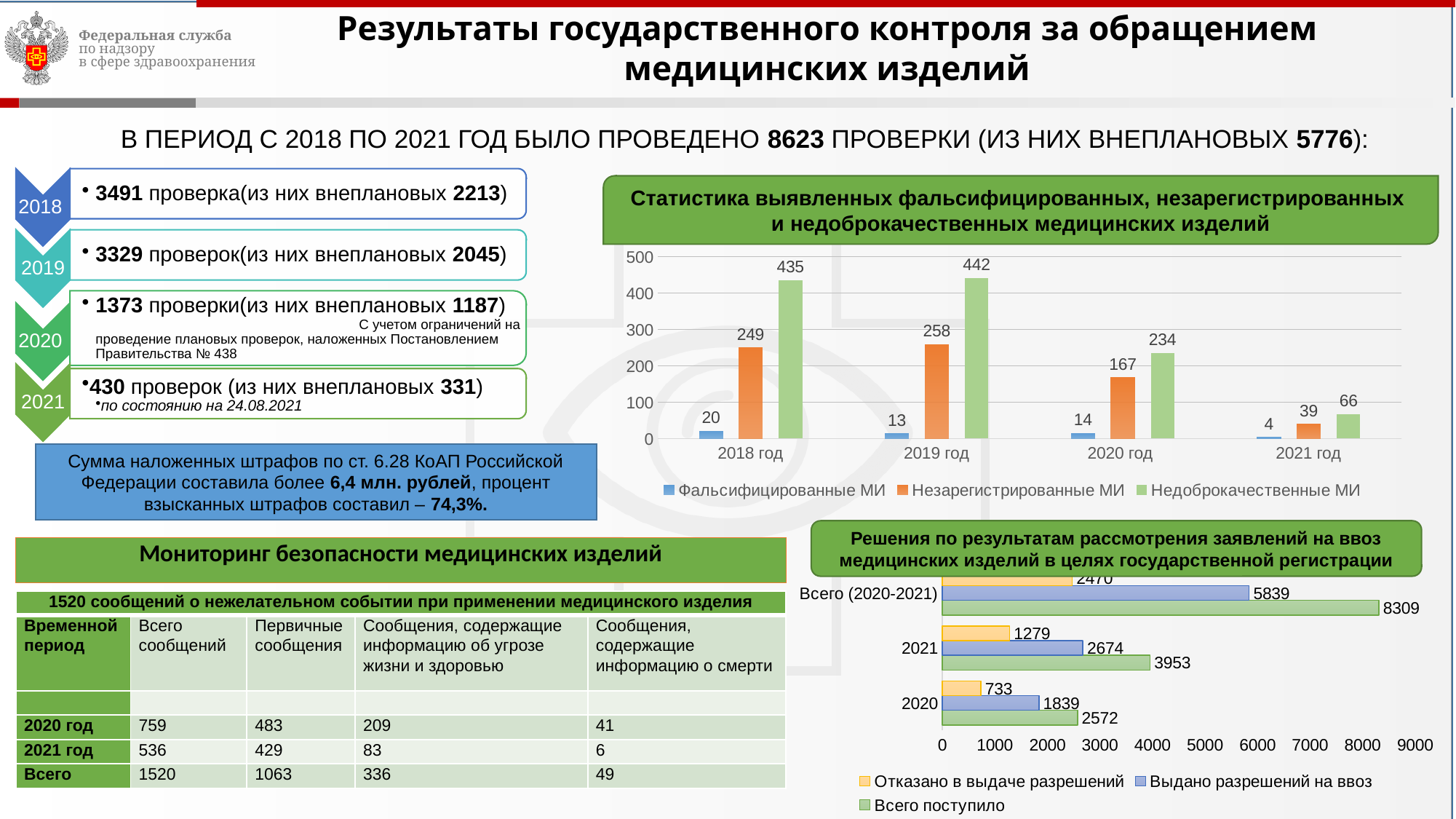
In the chart 'Статистика выявленных фальсифицированных, незарегистрированных и недоброкачественных медицинских изделий', which year has the highest value for Незарегистрированные МИ? 2019 год In the chart 'Статистика выявленных фальсифицированных, незарегистрированных и недоброкачественных медицинских изделий', what is the value for Фальсифицированные МИ in 2021 год? 4 In the chart 'Решения по результатам рассмотрения заявлений на ввоз медицинских изделий в целях государственной регистрации', which is larger: Отказано в выдаче разрешений in 2021 or in 2020? 2021 In the chart 'Статистика выявленных фальсифицированных, незарегистрированных и недоброкачественных медицинских изделий', what is the difference between Недоброкачественные МИ in 2018 год and 2020 год? 201 In the chart 'Статистика выявленных фальсифицированных, незарегистрированных и недоброкачественных медицинских изделий', does the value for Недоброкачественные МИ rise or fall from 2019 год to 2021 год? fall What kind of chart is 'Решения по результатам рассмотрения заявлений на ввоз медицинских изделий в целях государственной регистрации'? bar chart In the chart 'Решения по результатам рассмотрения заявлений на ввоз медицинских изделий в целях государственной регистрации', what is the difference between Всего поступило in 2021 and in 2020? 1381 In the chart 'Решения по результатам рассмотрения заявлений на ввоз медицинских изделий в целях государственной регистрации', how many categories are shown on the vertical axis? 3 In the chart 'Решения по результатам рассмотрения заявлений на ввоз медицинских изделий в целях государственной регистрации', what is the value for Всего поступило in 2020? 2572 In the chart 'Статистика выявленных фальсифицированных, незарегистрированных и недоброкачественных медицинских изделий', how many series does the legend list? 3 In the chart 'Решения по результатам рассмотрения заявлений на ввоз медицинских изделий в целях государственной регистрации', what is the value for Выдано разрешений на ввоз in 2021? 2674 In the chart 'Статистика выявленных фальсифицированных, незарегистрированных и недоброкачественных медицинских изделий', what is the value for Недоброкачественные МИ in 2019 год? 442